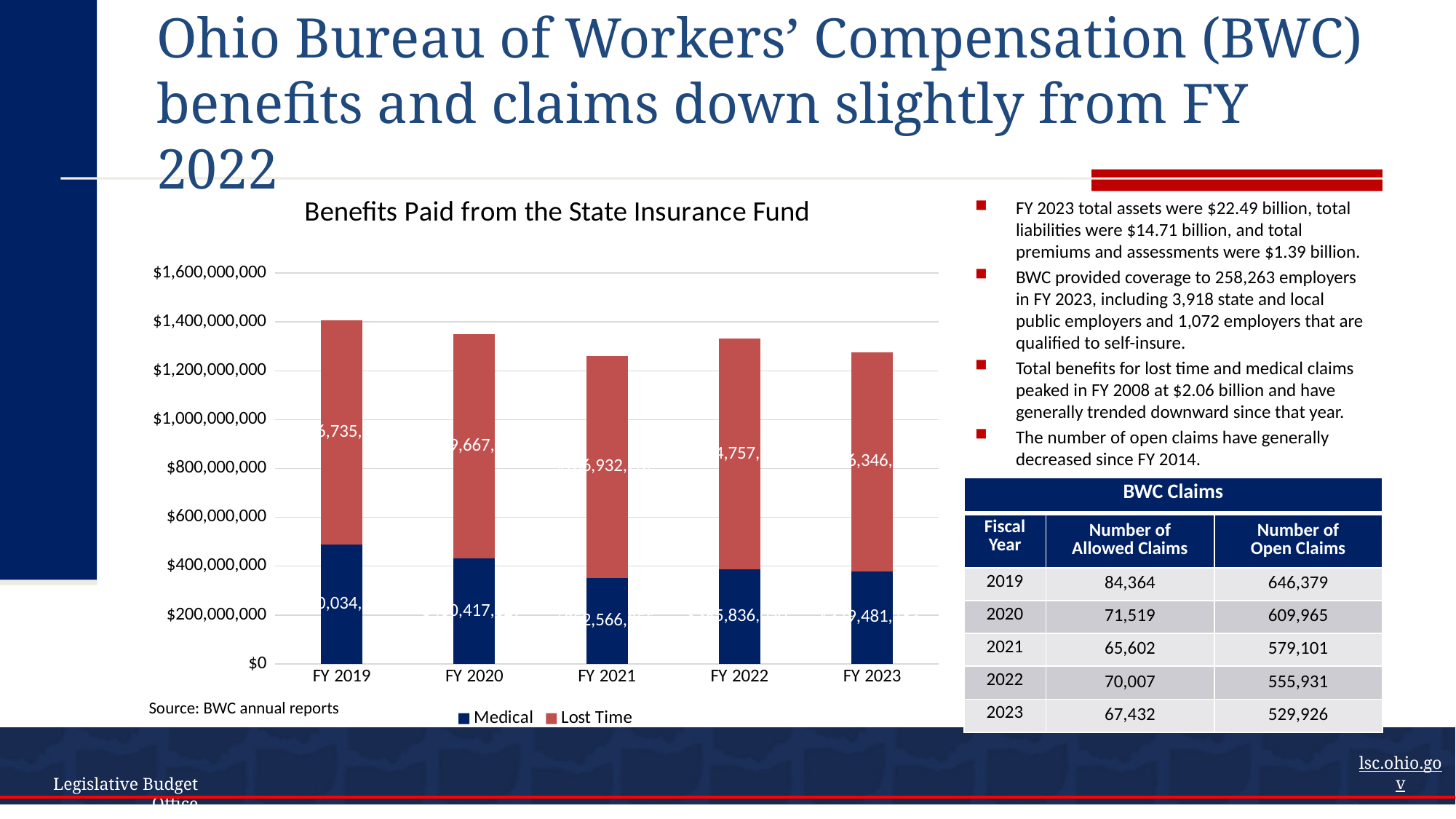
Is the Medical value for FY 2021 greater or less than $400,000,000? less How many fiscal years are plotted on the x axis of the chart? 5 Overall, do total benefits paid rise or fall from FY 2019 to FY 2023 in the chart? fall How many series does the chart's legend list? 2 Is the Medical value for FY 2019 greater or less than $400,000,000? greater Is the total benefits paid for FY 2021 greater or less than $1,400,000,000? less Which fiscal year has the lowest total benefits paid in the chart? FY 2021 Which has the larger total benefits paid, FY 2019 or FY 2023? FY 2019 Which two series are shown in the chart's legend? Medical and Lost Time Which fiscal year has the highest total benefits paid in the chart? FY 2019 What kind of chart is shown on the slide? Stacked bar chart What is the title of the chart on the slide? Benefits Paid from the State Insurance Fund